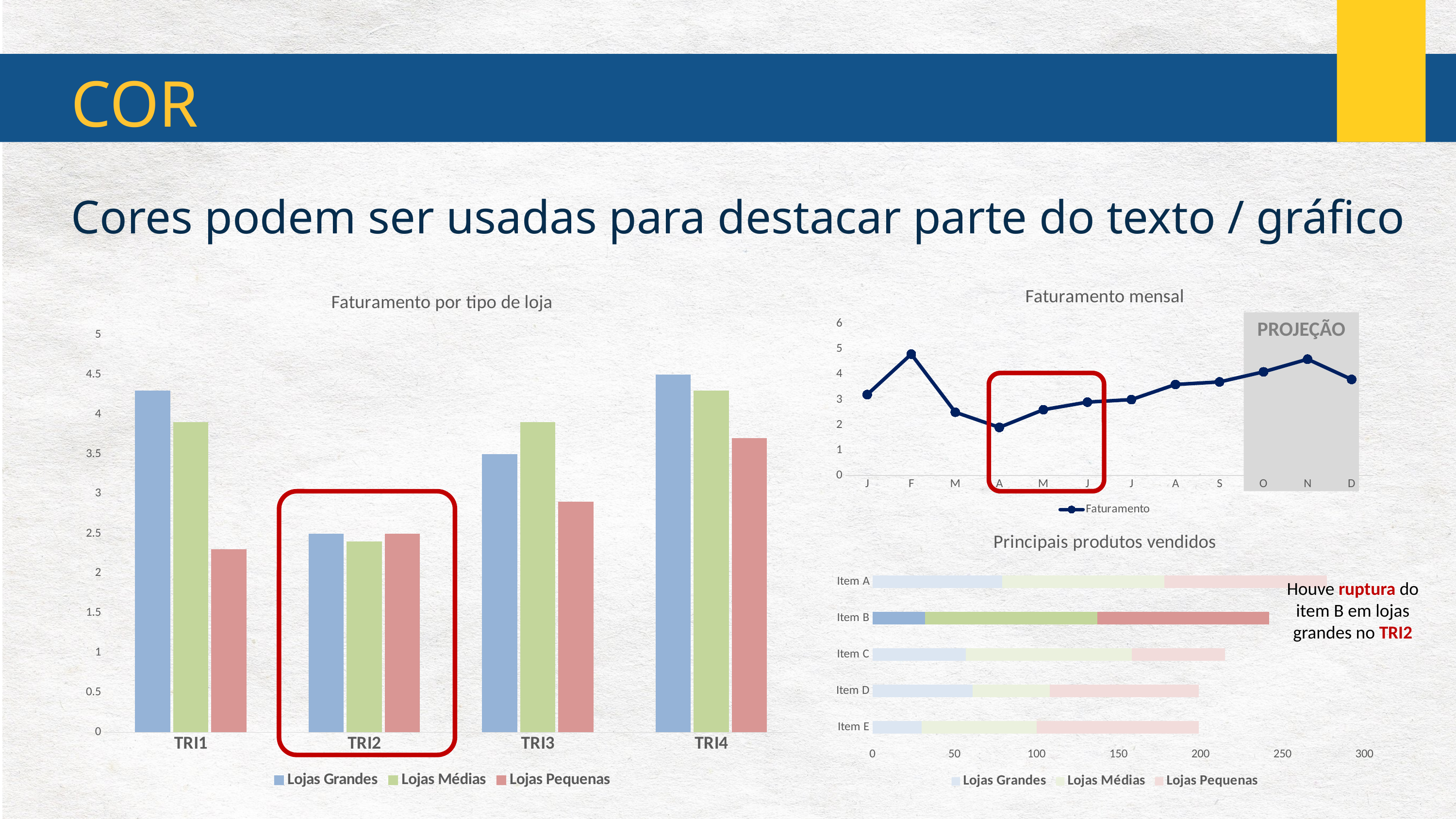
In "Faturamento mensal", is the value for F greater or less than 4? greater How many points are plotted in "Faturamento mensal"? 12 What kind of chart is "Faturamento mensal"? line chart How many categories are shown on the x axis of "Faturamento por tipo de loja"? 4 In "Faturamento por tipo de loja", is the value for Lojas Grandes in TRI1 greater or less than 4? greater In "Faturamento mensal", which month has the highest value? F How many series does the legend of "Faturamento por tipo de loja" list? 3 In "Faturamento mensal", which month has the lowest value? A In "Faturamento por tipo de loja", which series has the lowest value in TRI1? Lojas Pequenas What kind of chart is "Faturamento por tipo de loja"? bar chart How many items are listed in "Principais produtos vendidos"? 5 In "Principais produtos vendidos", which item has the longest total bar? Item A